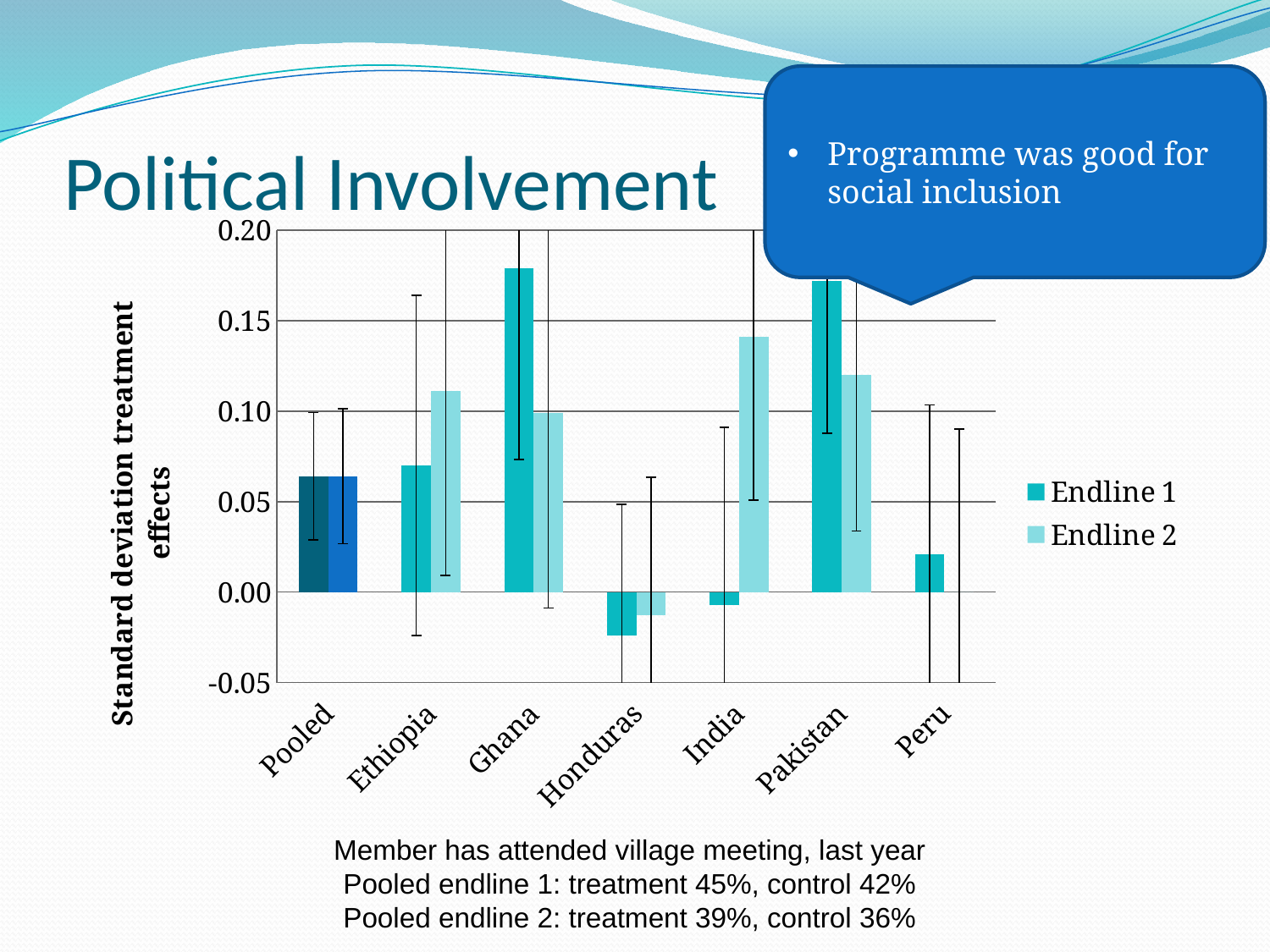
What are the two series named in the legend? Endline 1 and Endline 2 Is the Endline 1 value for Honduras greater or less than 0.00? less Is the Endline 1 value for Ghana greater or less than 0.15? greater What is the title of the vertical axis? Standard deviation treatment effects For Ghana, which is larger: the Endline 1 value or the Endline 2 value? Endline 1 How many categories are shown along the x axis of the chart? 7 Which category has the highest Endline 1 value? Ghana Is the Endline 2 value for India greater or less than 0.10? greater How many series does the chart's legend list? 2 What kind of chart is shown on the slide? Bar chart Which category has the lowest Endline 1 value? Honduras